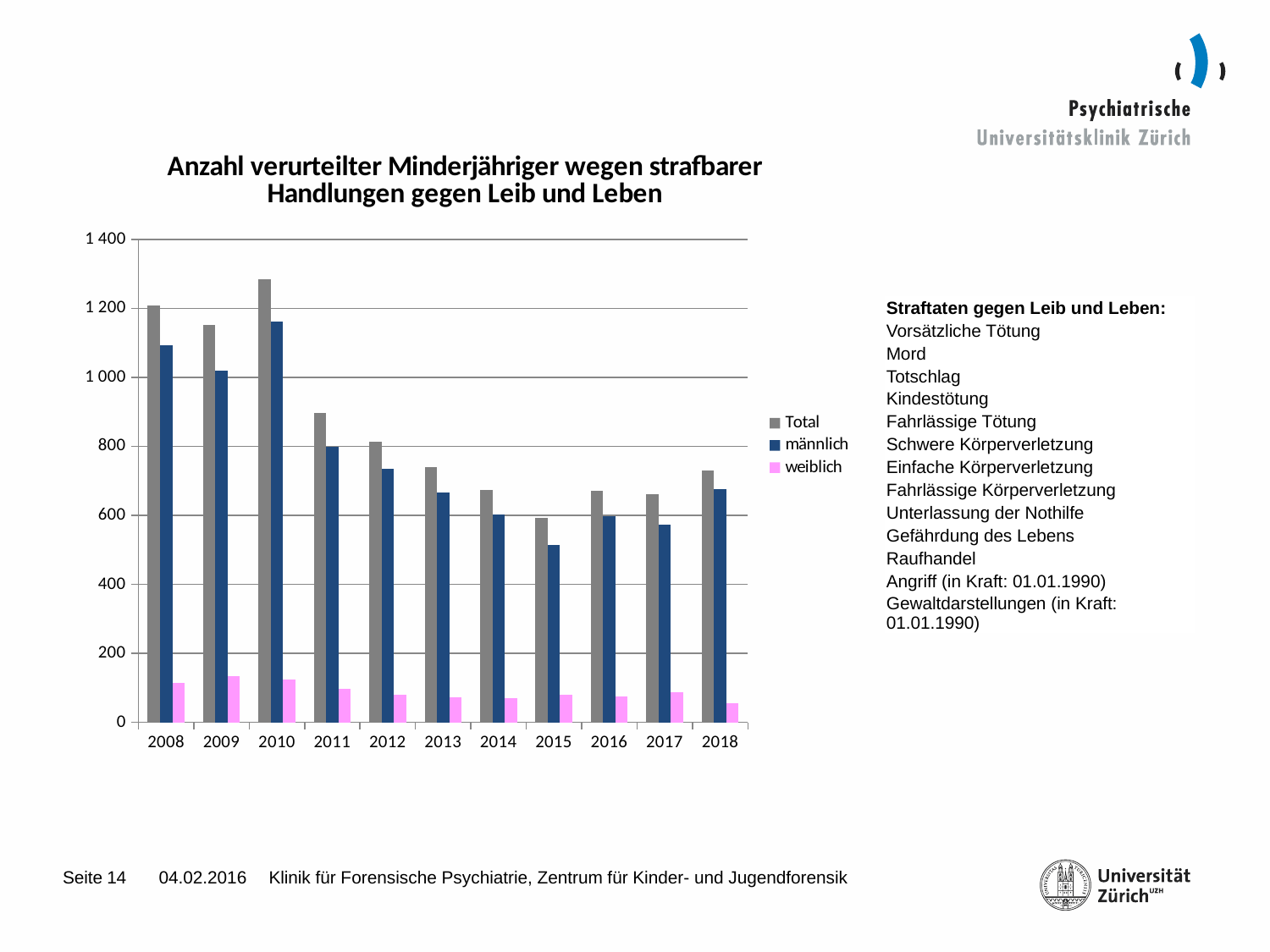
In which year is the männlich value lowest? 2015 How many series does the legend list? 3 Is the männlich value for 2015 greater or less than 600? less Is the Total value for 2011 greater or less than 1 000? less In which year is the Total value highest? 2010 What kind of chart is shown on the slide? bar chart How many years are shown on the x axis? 11 Which is larger, the Total value for 2009 or for 2011? 2009 Is the Total value for 2010 greater or less than 1 200? greater In which year is the Total value lowest? 2015 Does the Total value generally rise or fall from 2008 to 2015? fall Which is larger, the männlich value for 2014 or for 2018? 2018